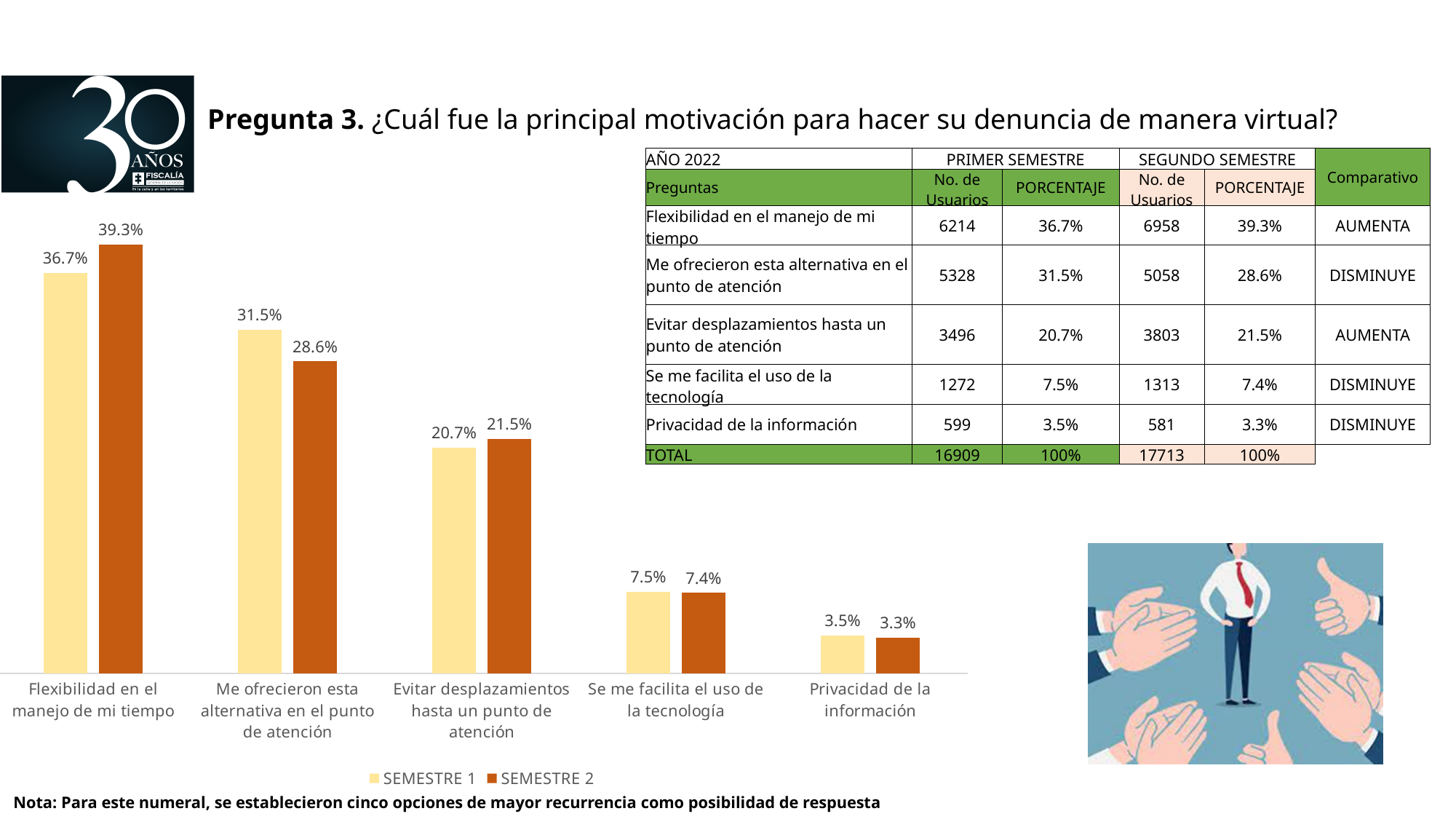
Do the SEMESTRE 2 values rise or fall from left to right across the categories? Fall What is the SEMESTRE 1 value for "Privacidad de la información"? 3.5% What is the SEMESTRE 1 value for "Evitar desplazamientos hasta un punto de atención"? 20.7% What is the difference between the SEMESTRE 1 and SEMESTRE 2 values for "Me ofrecieron esta alternativa en el punto de atención"? 2.9% What is the SEMESTRE 2 value for "Flexibilidad en el manejo de mi tiempo"? 39.3% Which category has the lowest SEMESTRE 2 value? Privacidad de la información For "Se me facilita el uso de la tecnología", which series has the larger value, SEMESTRE 1 or SEMESTRE 2? SEMESTRE 1 How many series does the chart legend list? 2 What kind of chart is shown on the slide? Bar chart Which category has the highest SEMESTRE 1 value? Flexibilidad en el manejo de mi tiempo How many categories are shown on the x axis of the chart? 5 Which series is shown in the darker orange colour in the chart? SEMESTRE 2